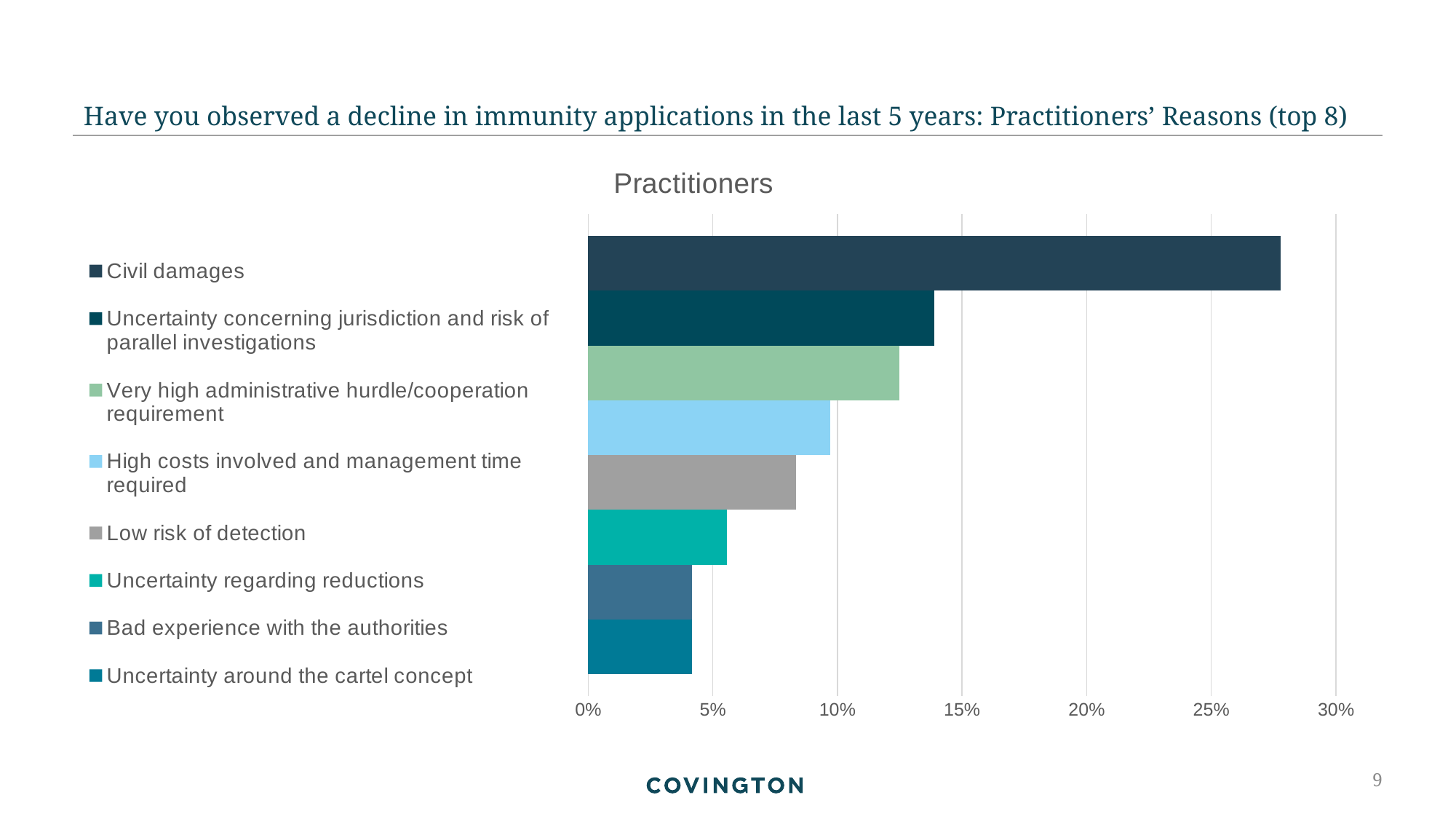
What is the title of the chart? Practitioners Which reason has the highest value in the chart? Civil damages Is the value for Low risk of detection greater or less than 10%? less Is the value for Uncertainty concerning jurisdiction and risk of parallel investigations greater or less than 15%? less Which is larger, the value for High costs involved and management time required or the value for Low risk of detection? High costs involved and management time required Is the value for Very high administrative hurdle/cooperation requirement greater or less than 10%? greater How many entries does the legend list? 8 Which is larger, the value for Civil damages or the value for Uncertainty concerning jurisdiction and risk of parallel investigations? Civil damages How many reasons (bars) are plotted in the chart? 8 What kind of chart is shown on the slide? bar chart